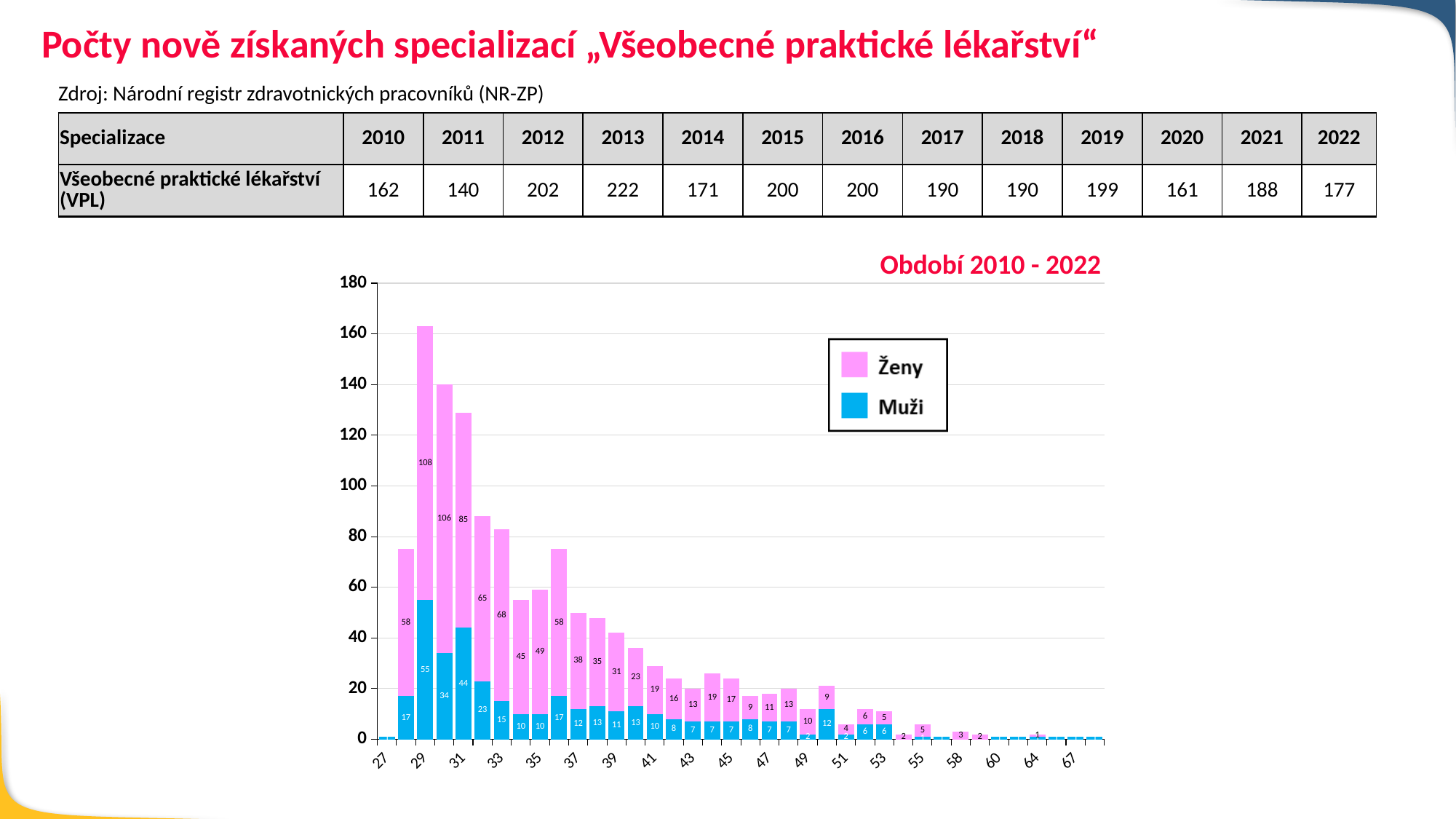
In the chart, which is larger, the Ženy value at age 33 or at age 35? age 33 Which colour represents Muži in the chart? blue In the chart, what is the value for Muži at age 33? 15 In the chart, what is the total height of the stacked bar at age 29? 163 How many series does the chart legend list? 2 What kind of chart is shown on the slide? stacked bar chart In the chart, what is the total height of the stacked bar at age 31? 129 In the chart, at which labelled age is the Muži value highest? 29 In the chart, what is the value for Muži at age 29? 55 In the chart, what is the value for Ženy at age 31? 85 In the chart, what is the value for Ženy at age 29? 108 In the chart, what is the difference between the Ženy and Muži values at age 29? 53